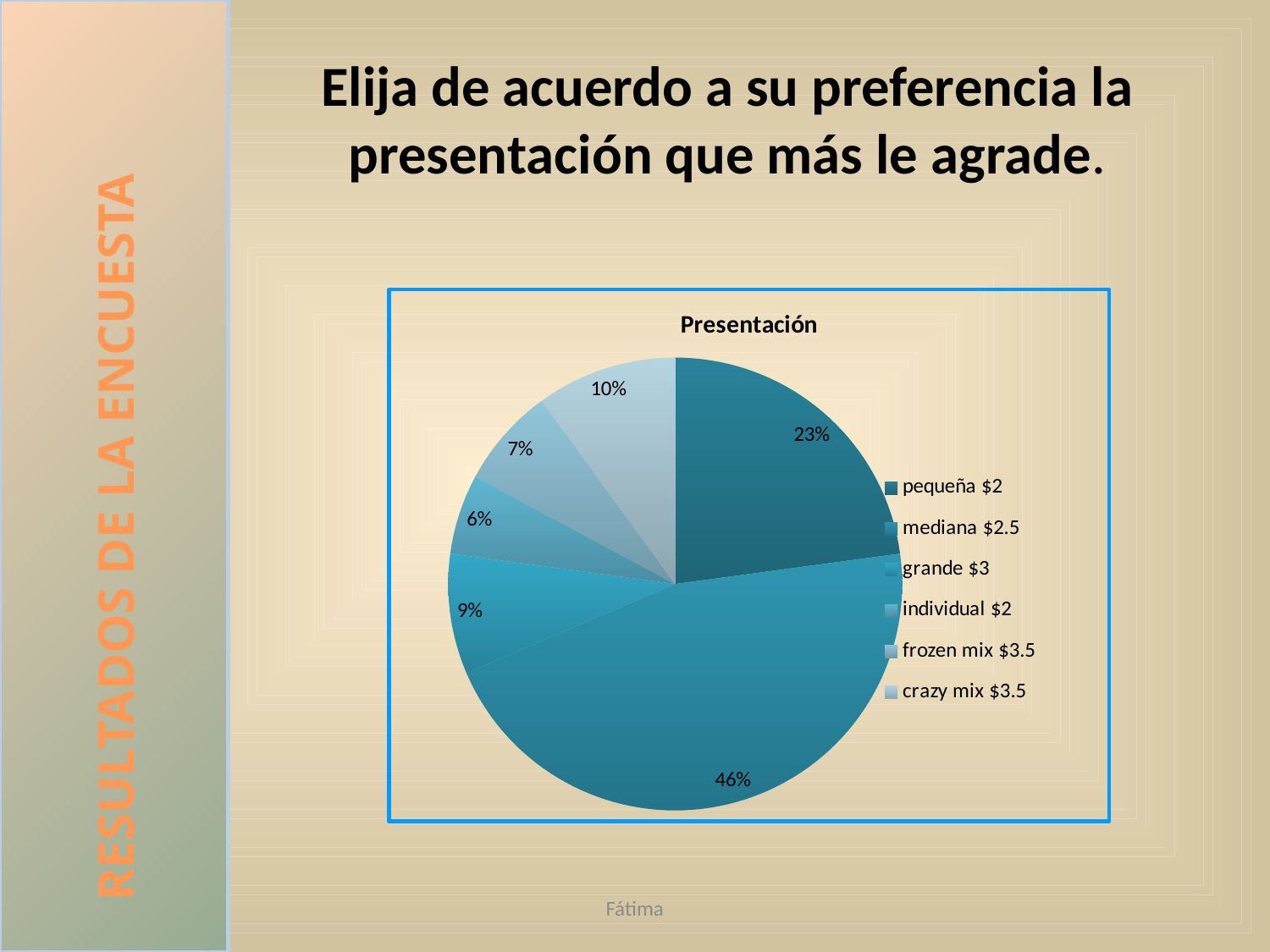
How many categories does the legend of the pie chart list? 6 What is the title of the chart? Presentación Which category has the largest slice of the pie? mediana $2.5 What kind of chart is shown on the slide? pie chart What share of the pie does "pequeña $2" have? 23% What is the combined share of the "frozen mix $3.5" and "crazy mix $3.5" slices? 17% What share of the pie does "individual $2" have? 6% What is the difference in percentage points between the "mediana $2.5" slice and the "pequeña $2" slice? 23 What share of the pie does "crazy mix $3.5" have? 10% Which category has the smallest slice of the pie? individual $2 Which slice is larger, "grande $3" or "frozen mix $3.5"? grande $3